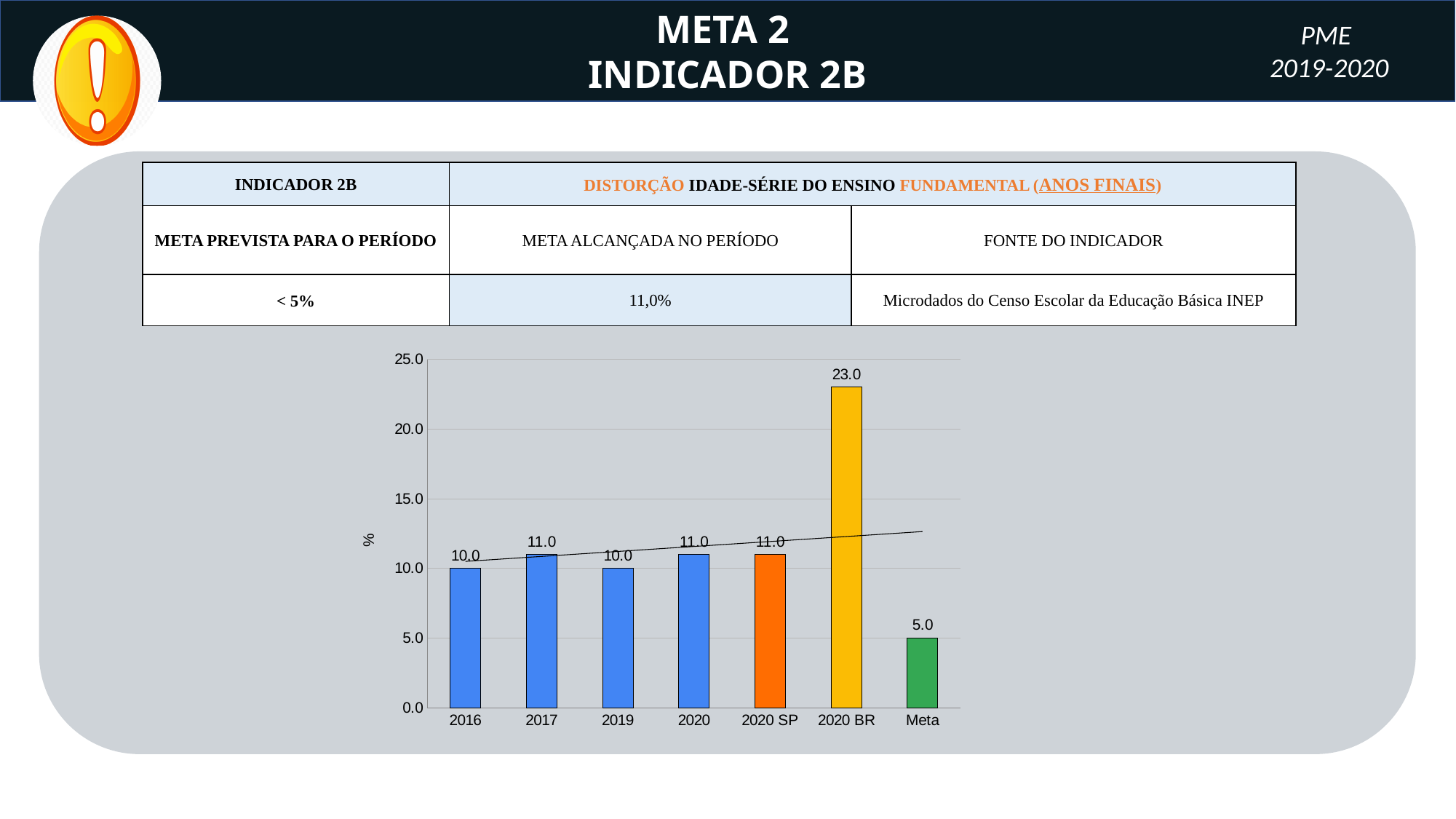
What is the value for 2016? 10.0 Which is larger, the value for 2017 or the value for 2019? 2017 How many bars are shown in the chart? 7 Which category has the lowest value? Meta What kind of chart is shown on the slide? bar chart What is the value for Meta? 5.0 Is the value for 2020 BR greater or less than 20.0? greater What is the value for 2020 BR? 23.0 What is the label on the vertical axis of the chart? % What is the difference between the values for 2020 BR and 2020 SP? 12.0 What is the value for 2020 SP? 11.0 Which category has the highest value? 2020 BR